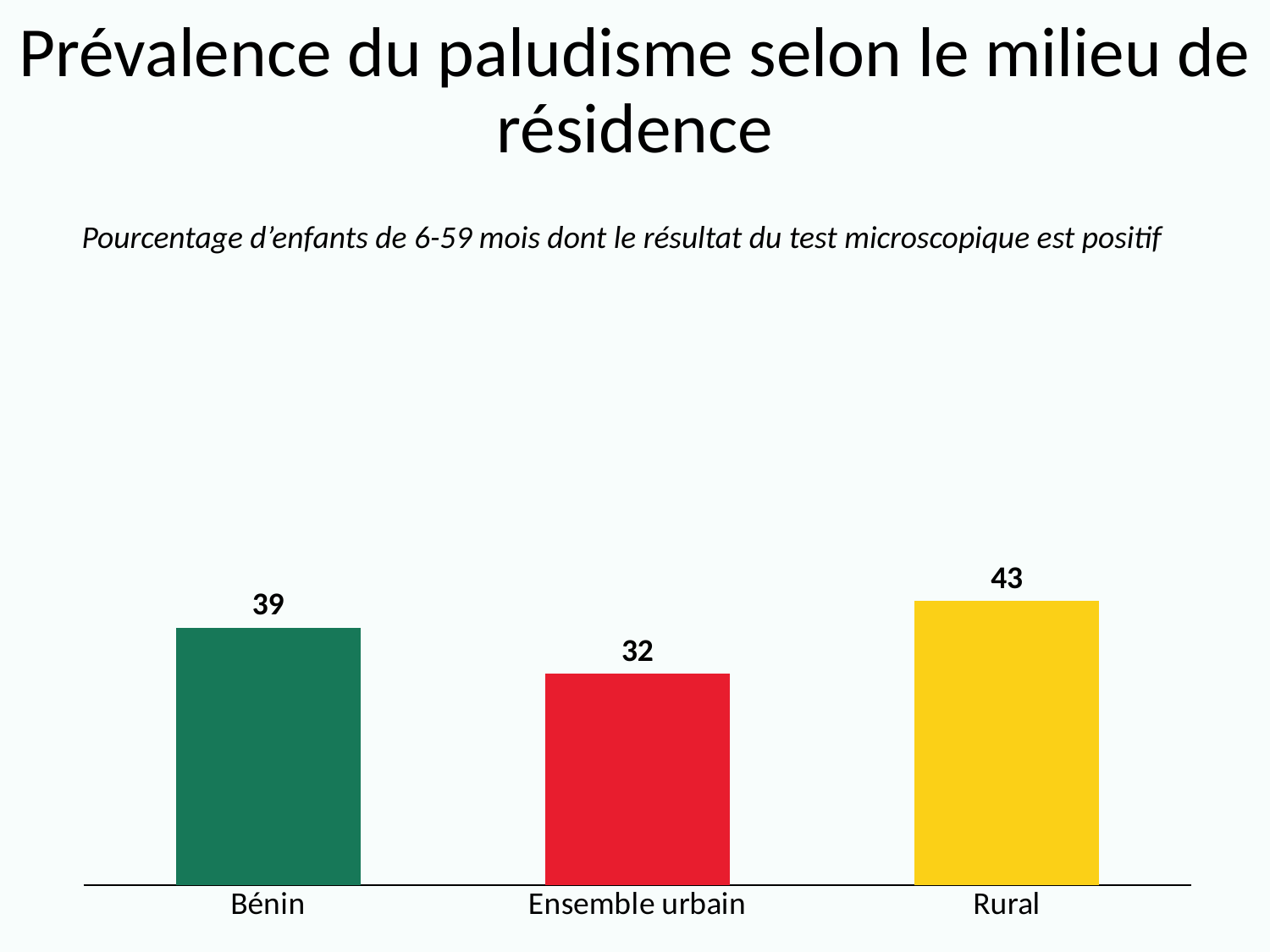
What is the difference between the values for Rural and Bénin? 4 What is the value for Bénin? 39 What kind of chart is shown on the slide? Bar chart What colour is the bar for Rural? Yellow Which is larger, the value for Bénin or the value for Ensemble urbain? Bénin Which category has the highest value? Rural What is the value for Rural? 43 What is the value for Ensemble urbain? 32 What is the title of the slide? Prévalence du paludisme selon le milieu de résidence What is the difference between the values for Rural and Ensemble urbain? 11 How many categories are shown in the chart? 3 Which category has the lowest value? Ensemble urbain